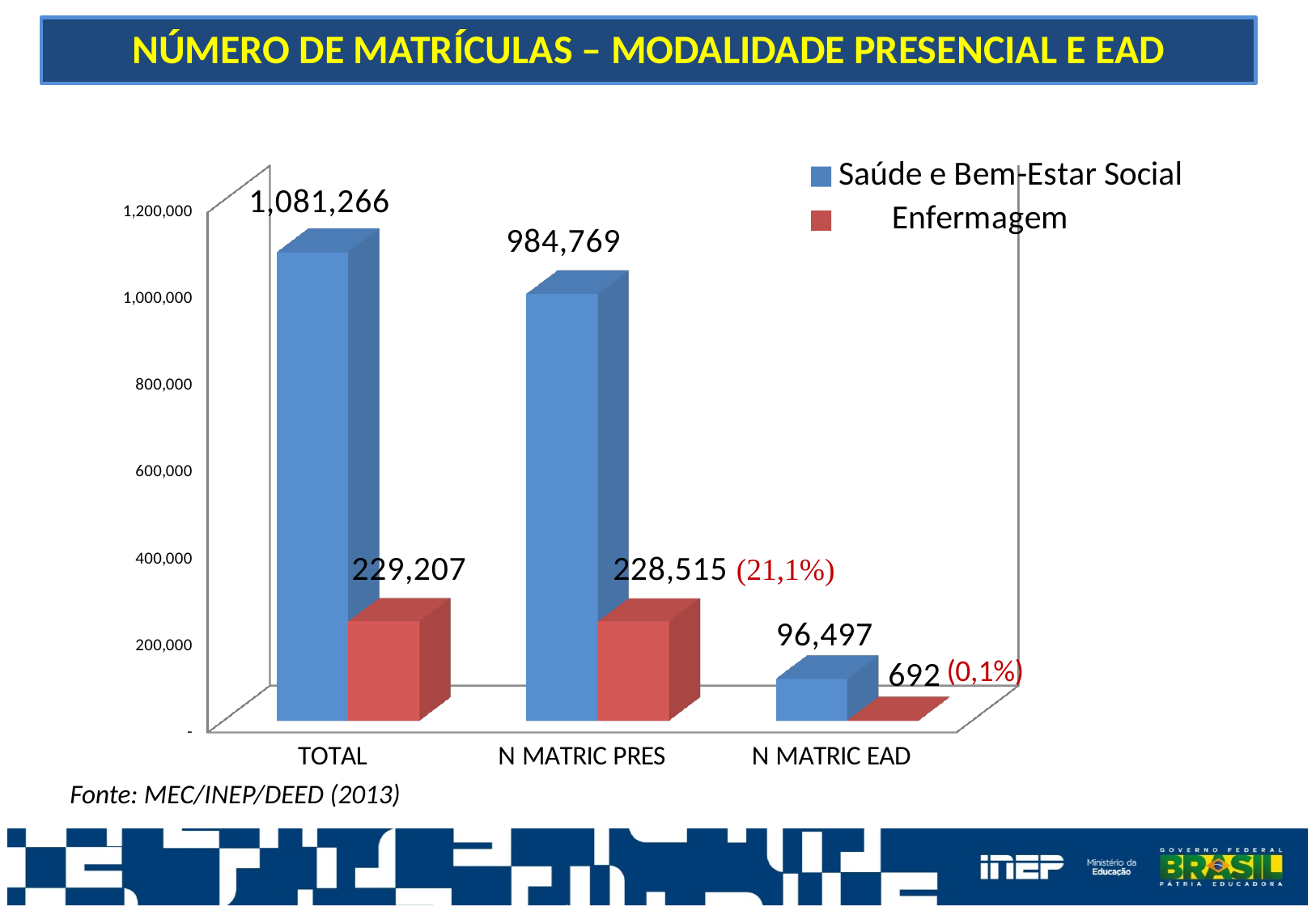
Which category has the highest value for Saúde e Bem-Estar Social? TOTAL What kind of chart is shown on the slide? Bar chart What is the value for Enfermagem in the N MATRIC EAD category? 692 How many categories are shown on the x axis? 3 Which is larger in the TOTAL category: Saúde e Bem-Estar Social or Enfermagem? Saúde e Bem-Estar Social What is the value for Saúde e Bem-Estar Social in the N MATRIC EAD category? 96,497 What is the value for Saúde e Bem-Estar Social in the TOTAL category? 1,081,266 What is the difference between the Saúde e Bem-Estar Social and Enfermagem values in the N MATRIC PRES category? 756,254 What is the value for Enfermagem in the N MATRIC PRES category? 228,515 How many series does the legend list? 2 What is the difference between the Saúde e Bem-Estar Social values for TOTAL and N MATRIC PRES? 96,497 Which category has the lowest value for Enfermagem? N MATRIC EAD